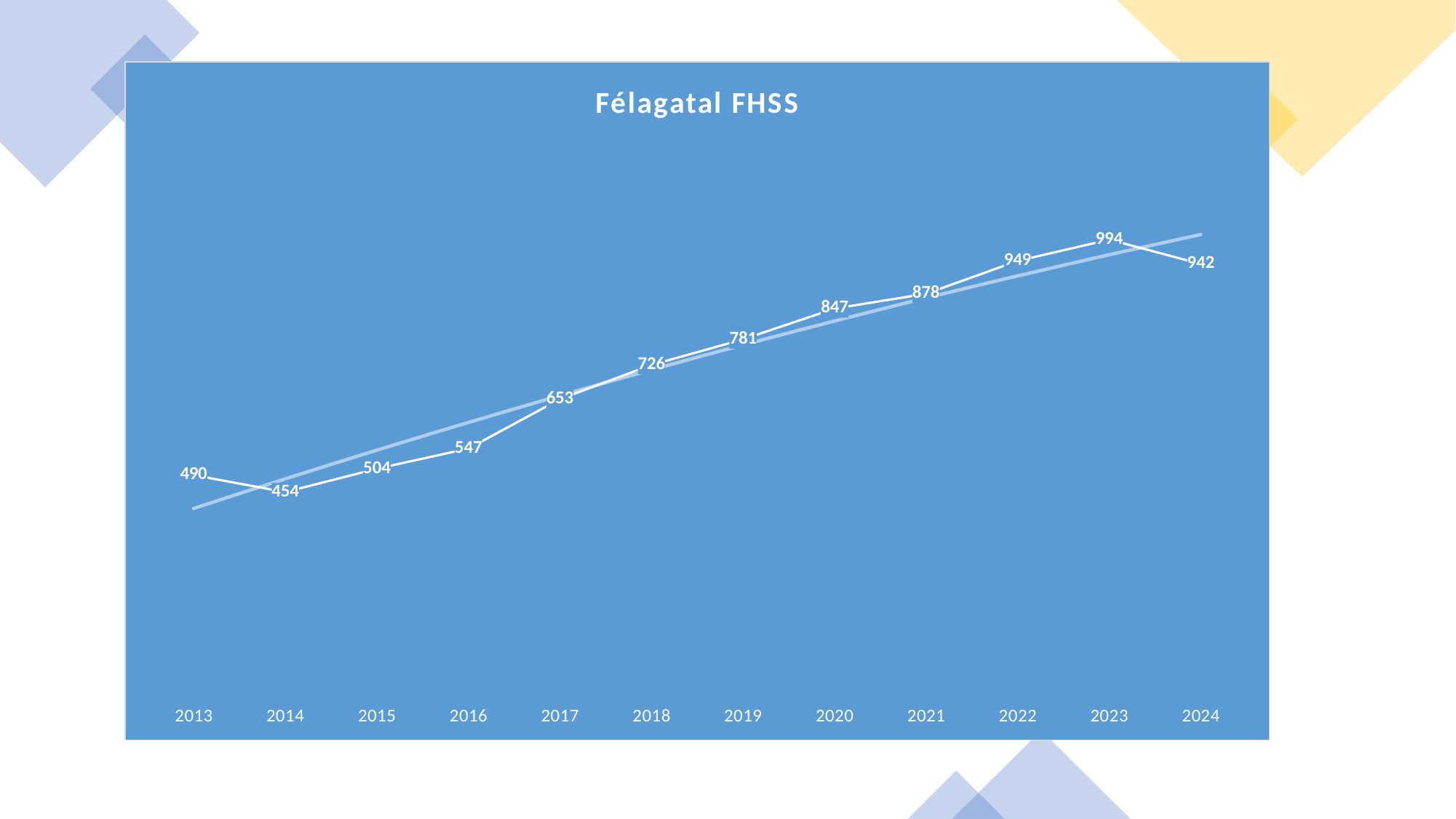
What is the difference between the values for 2017 and 2016? 106 How many years are plotted on the x axis? 12 What is the difference between the values for 2023 and 2024? 52 Which year has the lowest value? 2014 What is the value for 2019? 781 What is the title of the chart? Félagatal FHSS Which is larger, the value for 2013 or the value for 2014? 2013 Do the values generally rise or fall from 2014 to 2023? rise Which year has the highest value? 2023 What is the value for 2024? 942 What is the value for 2013? 490 What kind of chart is this? line chart